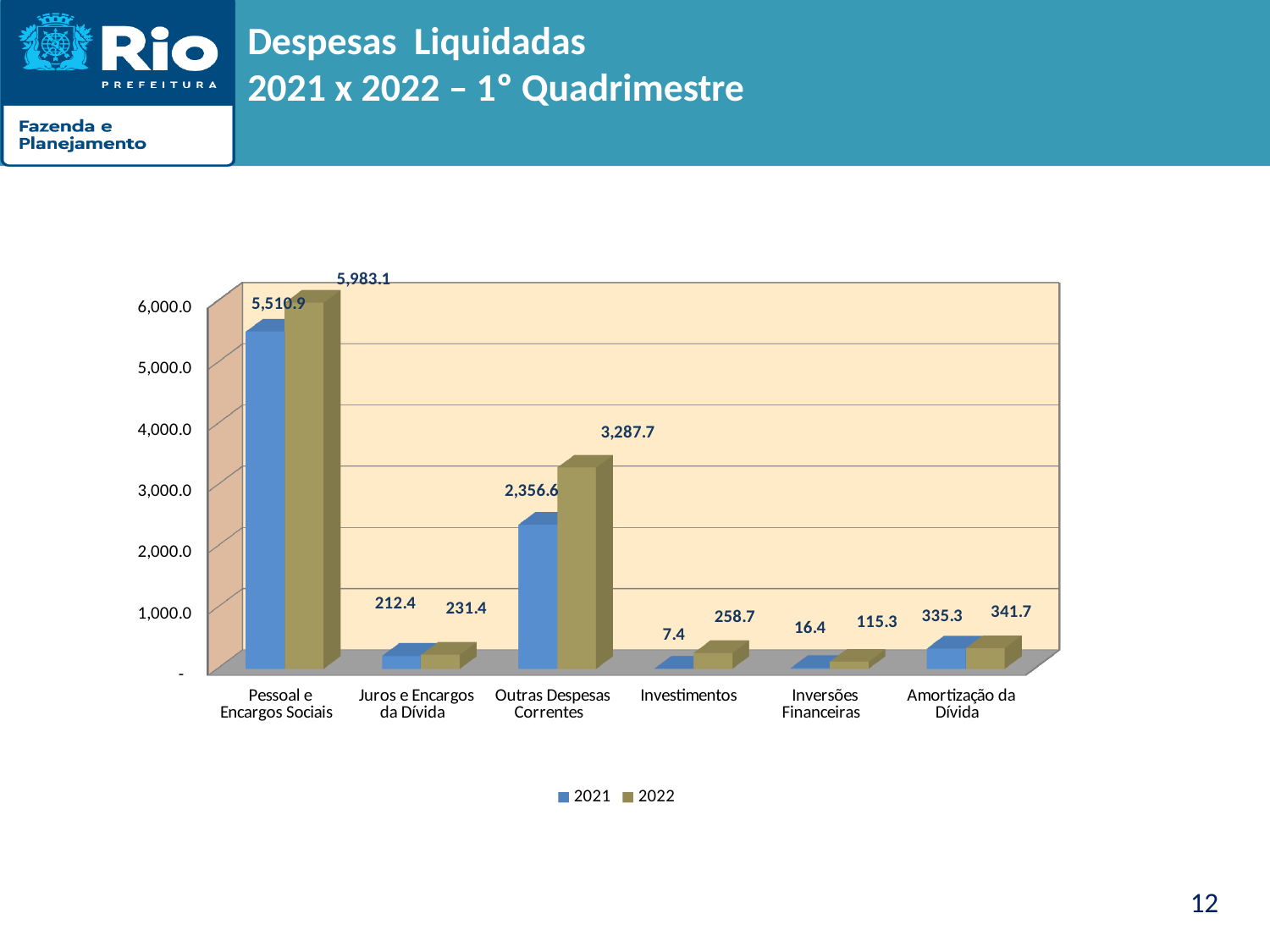
Which is larger for Amortização da Dívida, the 2021 value or the 2022 value? 2022 How many series does the legend list? 2 What kind of chart is shown on the slide? Bar chart Which series is shown in blue in the legend? 2021 Which category has the highest 2022 value? Pessoal e Encargos Sociais What is the 2021 value for Outras Despesas Correntes? 2,356.6 What is the 2022 value for Pessoal e Encargos Sociais? 5,983.1 Which category has the lowest 2021 value? Investimentos What is the 2022 value for Inversões Financeiras? 115.3 What is the difference between the 2022 and 2021 values for Outras Despesas Correntes? 931.1 What is the 2021 value for Investimentos? 7.4 How many categories are shown on the x axis? 6